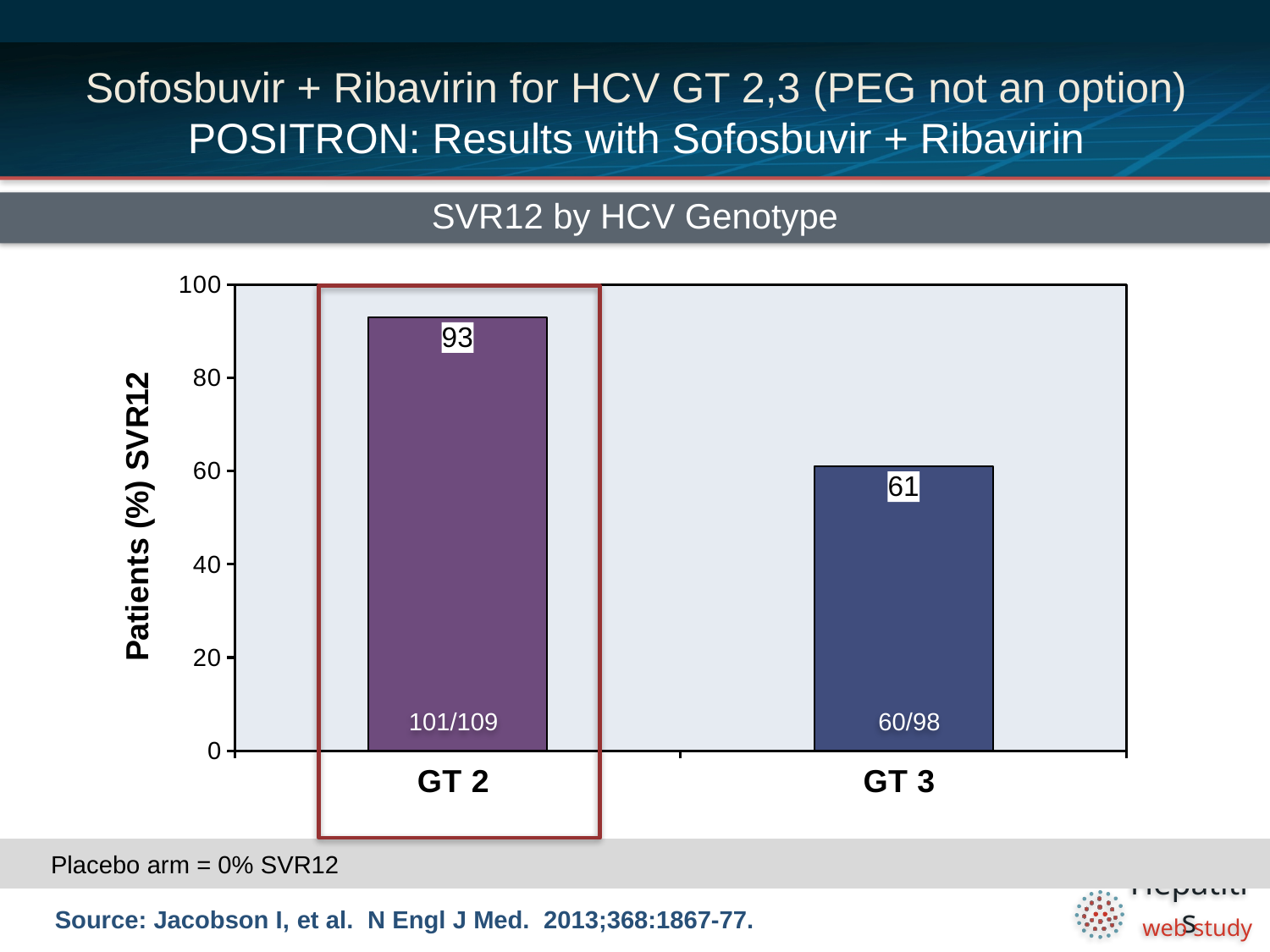
How many genotype categories are shown in the chart? 2 What fraction of patients is printed on the GT 3 bar? 60/98 Which genotype has the lowest SVR12? GT 3 What is the title of the chart? SVR12 by HCV Genotype Which has a larger SVR12 value, GT 2 or GT 3? GT 2 Is the SVR12 value for GT 3 greater or less than 80? less What is the difference in SVR12 between GT 2 and GT 3? 32 What is the SVR12 value for GT 3? 61 What fraction of patients is printed on the GT 2 bar? 101/109 Which genotype has the highest SVR12? GT 2 What is the SVR12 value for GT 2? 93 What kind of chart is shown on the slide? bar chart